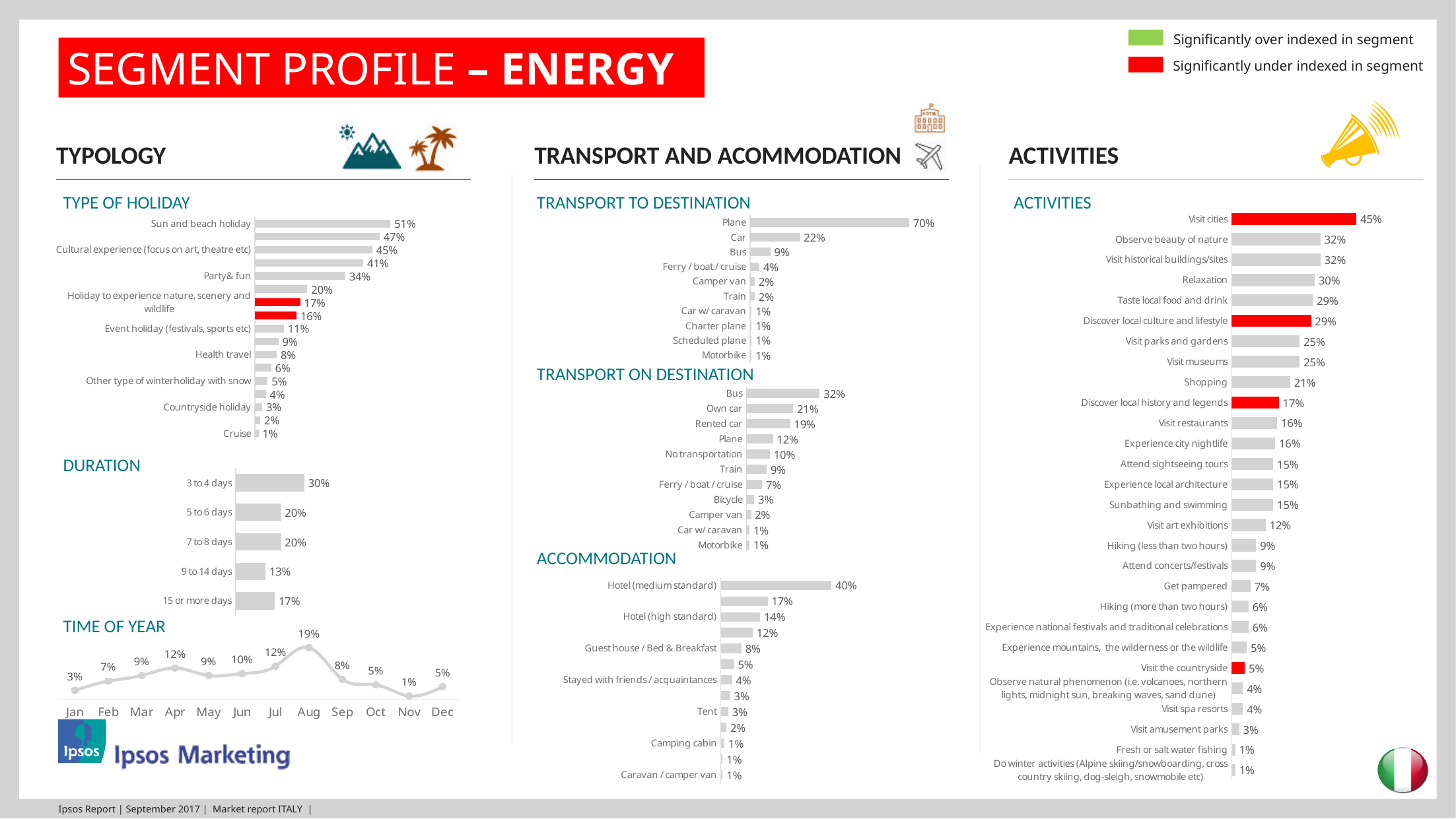
In the Transport to Destination chart, what is the value for Plane? 70% In the Accommodation chart, what is the value for Hotel (medium standard)? 40% In the Activities chart, what is the value for Shopping? 21% In the Transport on Destination chart, what is the difference between Bus and Own car? 11% In the Activities chart, what does a red bar indicate according to the legend? Significantly under indexed in segment What kind of chart is the Time of Year chart? Line chart In the Time of Year chart, which month has the highest value? Aug In the Duration chart, which duration has the lowest value? 9 to 14 days In the Type of Holiday chart, which is larger: Sun and beach holiday or Party & fun? Sun and beach holiday In the Time of Year chart, what is the value for Nov? 1% How many categories does the Duration chart show? 5 In the Activities chart, which activity has the highest value? Visit cities